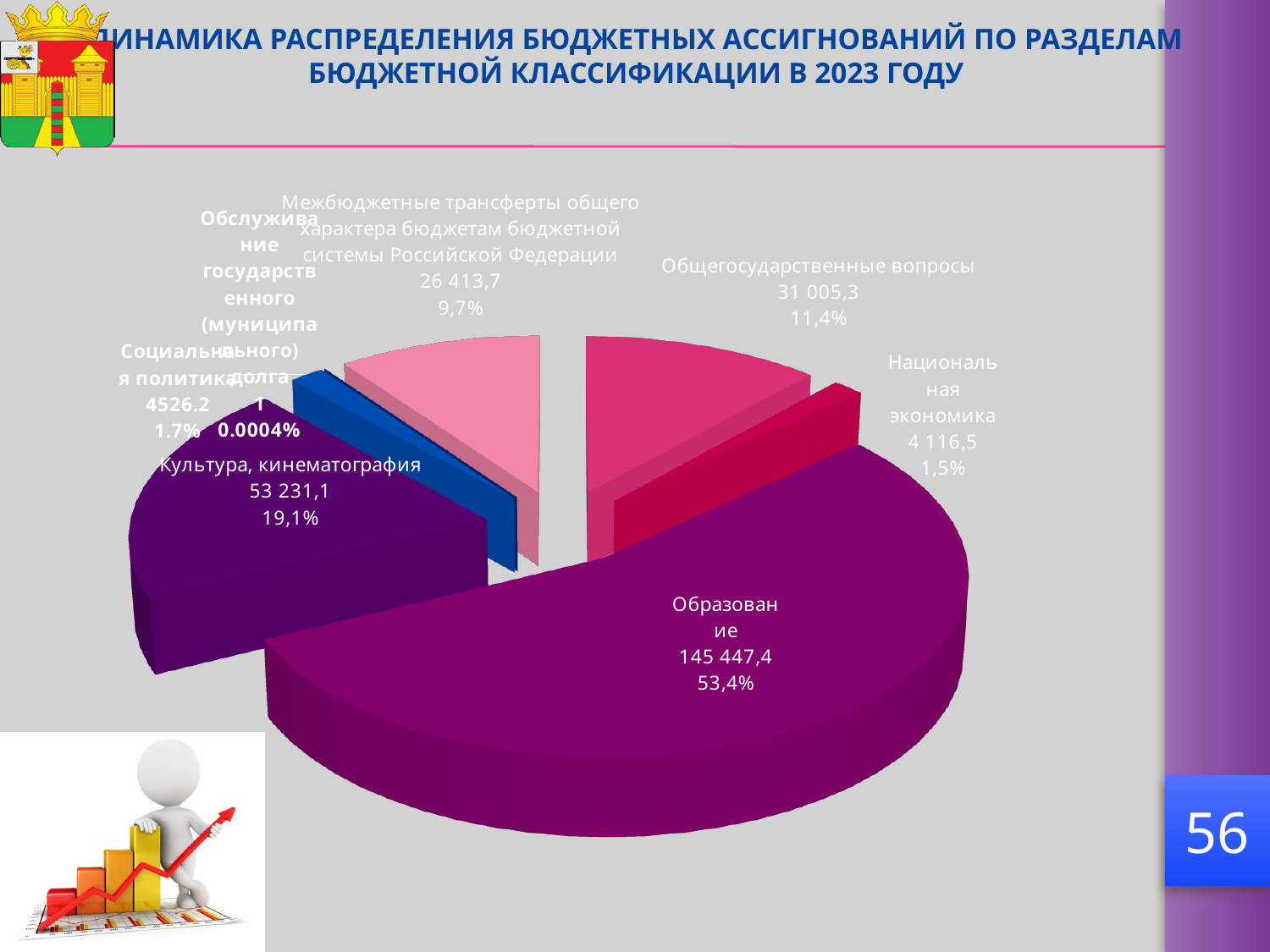
How many categories (slices) does the pie chart show? 7 Which category has the largest slice of the pie? Образование What percentage is shown for Общегосударственные вопросы? 11,4% What is the value shown for Культура, кинематография? 53 231,1 Which is larger: Общегосударственные вопросы or Национальная экономика? Общегосударственные вопросы What is the value shown for Национальная экономика? 4 116,5 What is the difference in percentage points between Образование (53,4%) and Культура, кинематография (19,1%)? 34,3 What percentage is shown for Межбюджетные трансферты общего характера бюджетам бюджетной системы Российской Федерации? 9,7% What kind of chart is shown on the slide? pie chart What is the value shown for Образование? 145 447,4 What share of the pie does Образование represent? 53,4% Which category has the smallest slice of the pie? Обслуживание государственного (муниципального) долга